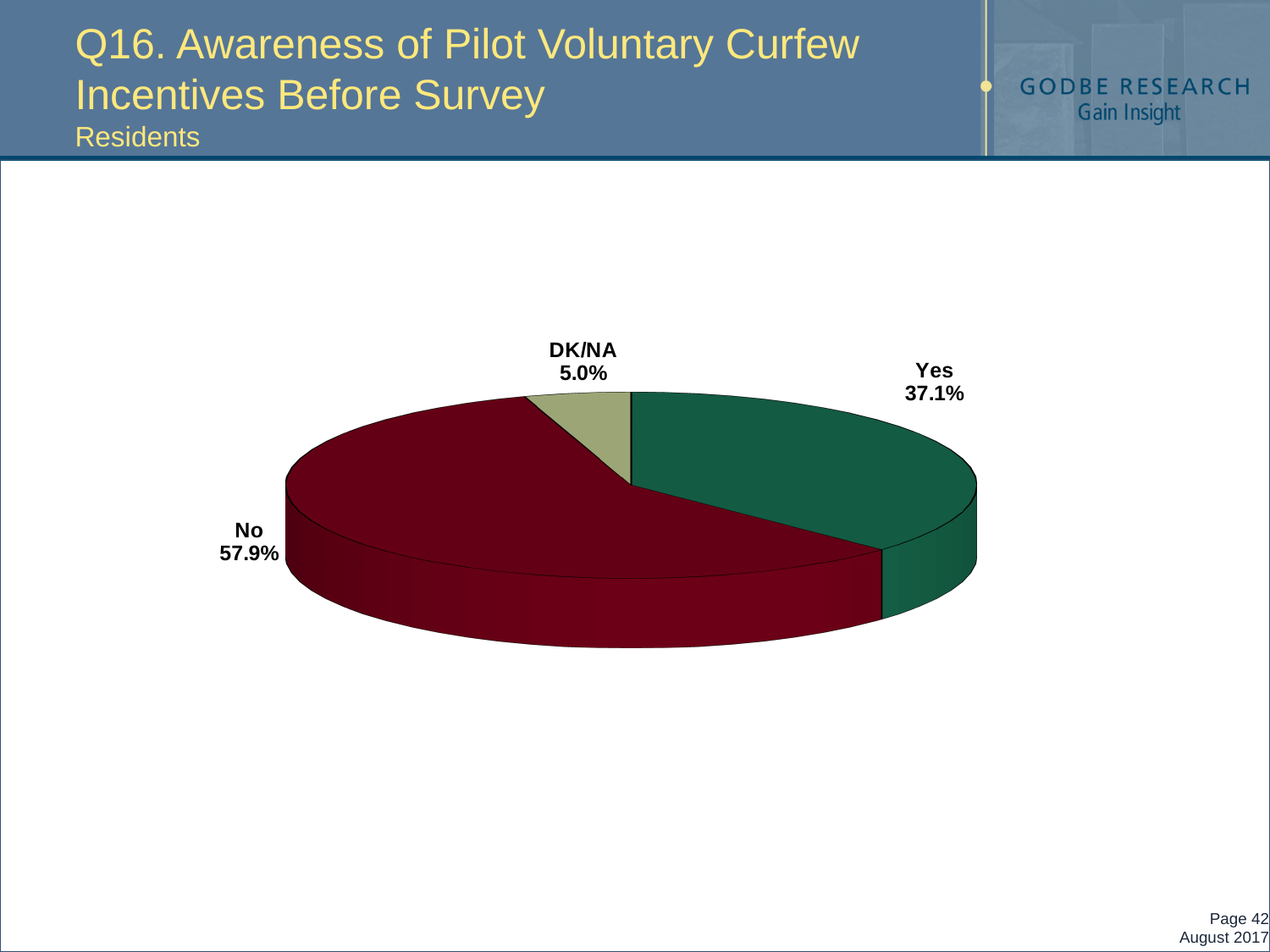
What percentage of residents answered "Yes"? 37.1% Which response has the largest share of the pie? No How many slices does the pie chart have? 3 Which group of respondents does the chart cover, according to the subtitle? Residents What percentage of residents answered "DK/NA"? 5.0% What kind of chart is shown on the slide? Pie chart What is the difference in percentage points between the "No" and "Yes" slices? 20.8 What percentage of residents answered "No"? 57.9% What share of the pie does the "Yes" slice represent? 37.1% Which response has the smallest share of the pie? DK/NA What colour is the "No" slice? Dark red Which is larger, the "Yes" slice or the "DK/NA" slice? Yes